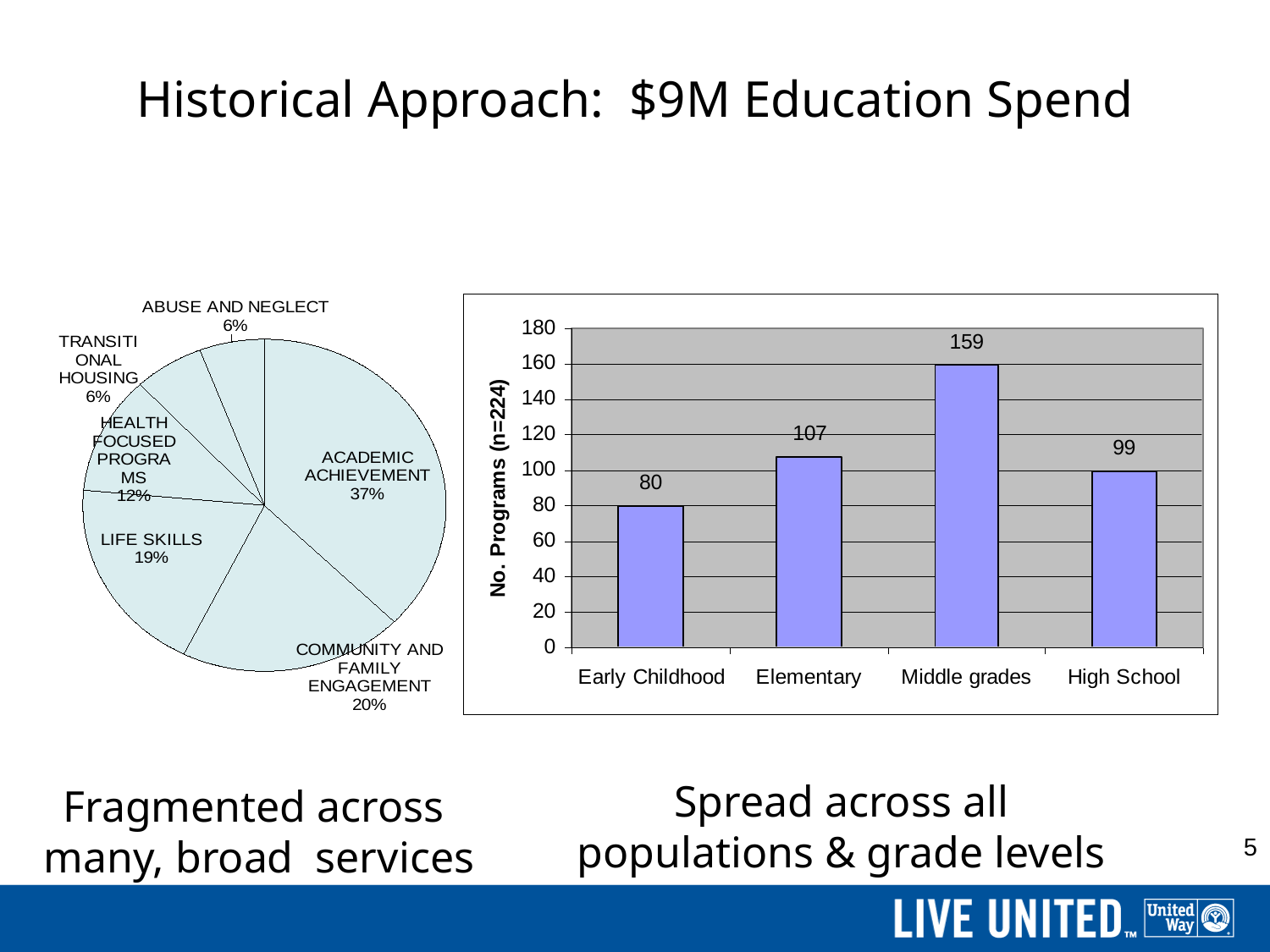
What is the y-axis label of the bar chart on the right? No. Programs (n=224) What kind of chart is the chart on the right of the slide? Bar chart In the bar chart on the right, how many categories are shown on the x axis? 4 In the bar chart on the right, which is larger: Elementary or High School? Elementary In the bar chart on the right, how many programs are there for Middle grades? 159 In the bar chart on the right, what is the value for Early Childhood? 80 In the bar chart on the right, which category has the lowest number of programs? Early Childhood In the pie chart on the left, how many slices are there? 6 In the pie chart on the left, what percentage is LIFE SKILLS? 19% In the pie chart on the left, what share does ACADEMIC ACHIEVEMENT have? 37% In the bar chart on the right, what is the difference between the Middle grades and High School values? 60 In the bar chart on the right, which category has the highest number of programs? Middle grades